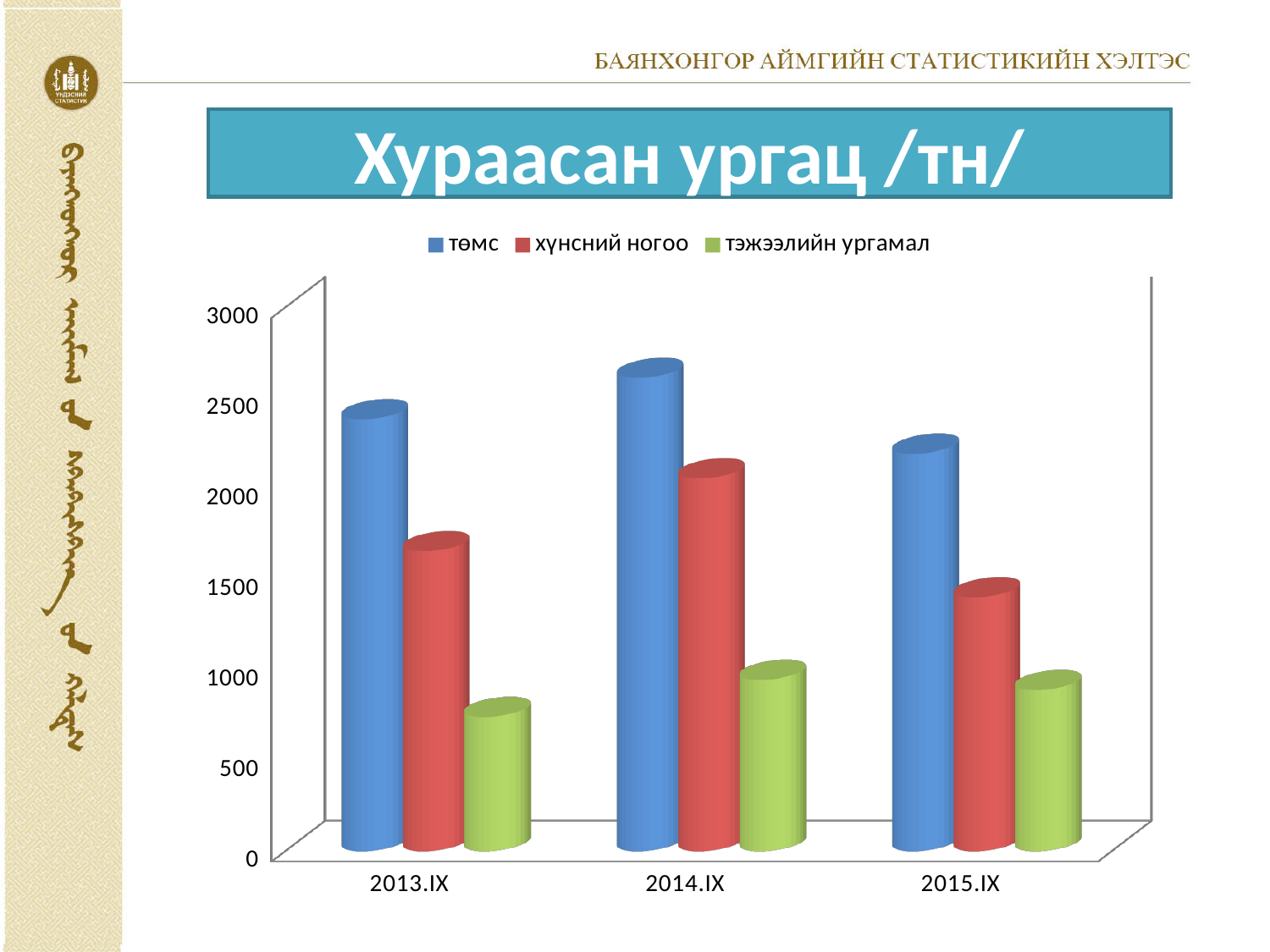
In which year is the value for тэжээлийн ургамал lowest? 2013.IX What is the title of the chart? Хураасан ургац /тн/ What kind of chart is shown on the slide? bar chart Is the value for төмс in 2013.IX greater or less than 2000? greater Which series is shown in green in the legend? тэжээлийн ургамал Is the value for хүнсний ногоо in 2015.IX greater or less than 2000? less Is the value for тэжээлийн ургамал in 2013.IX greater or less than 1000? less How many series does the legend list? 3 In which year is the value for төмс highest? 2014.IX How many categories are shown on the x axis? 3 How does the value for хүнсний ногоо change from 2014.IX to 2015.IX? it falls In 2013.IX, which is larger: төмс or хүнсний ногоо? төмс